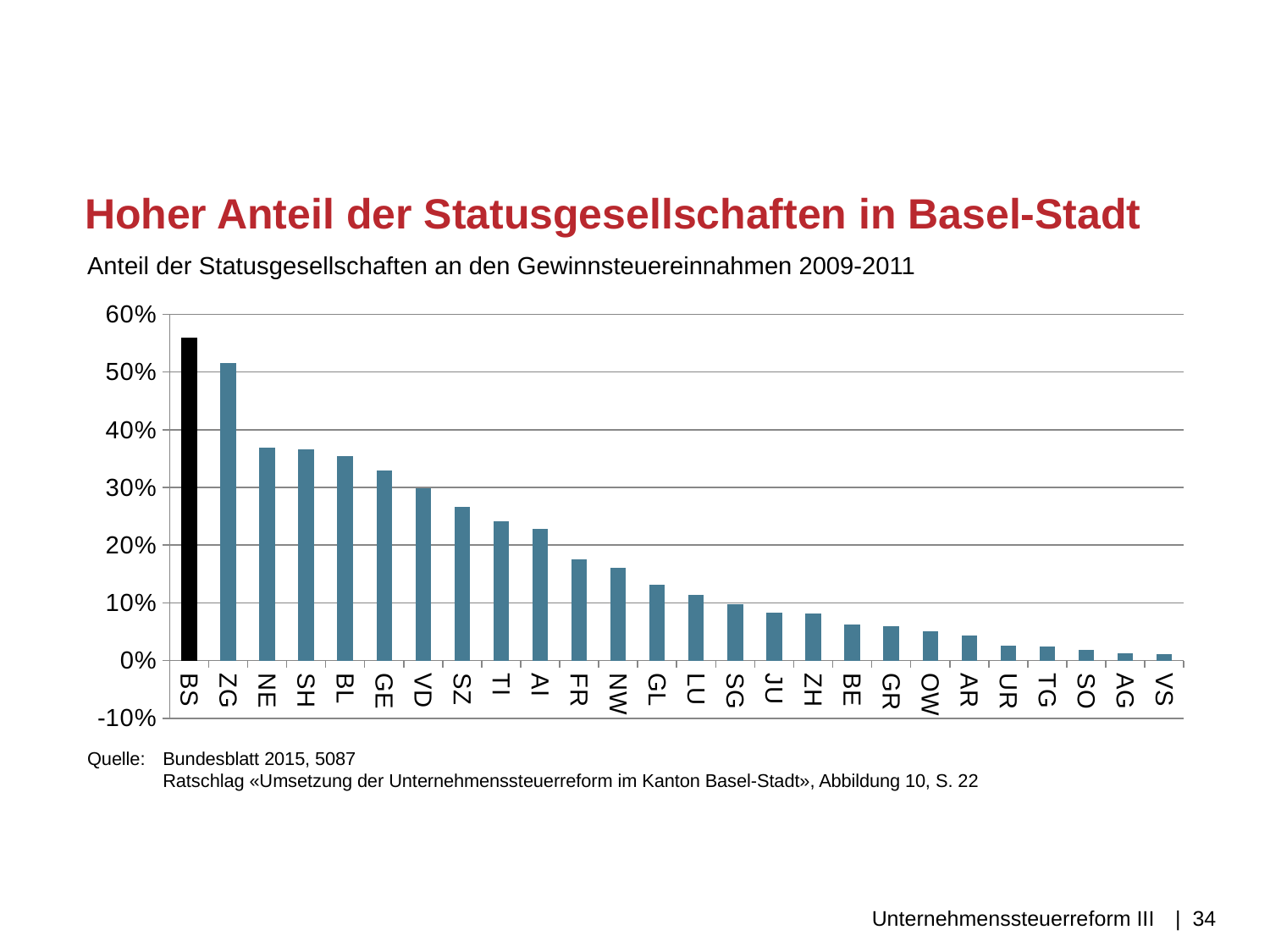
Do the values rise or fall from left to right along the x axis? fall Which canton's bar is coloured black instead of blue? BS Is the value for BE greater or less than 10%? less Is the value for SZ greater or less than 30%? less Which canton has the lowest share in the chart? VS What kind of chart is shown on the slide? bar chart Is the value for FR greater or less than 20%? less How many cantons are shown on the x axis of the chart? 26 Which has the larger value, BS or ZG? BS Which canton has the highest share of Statusgesellschaften in the Gewinnsteuereinnahmen? BS